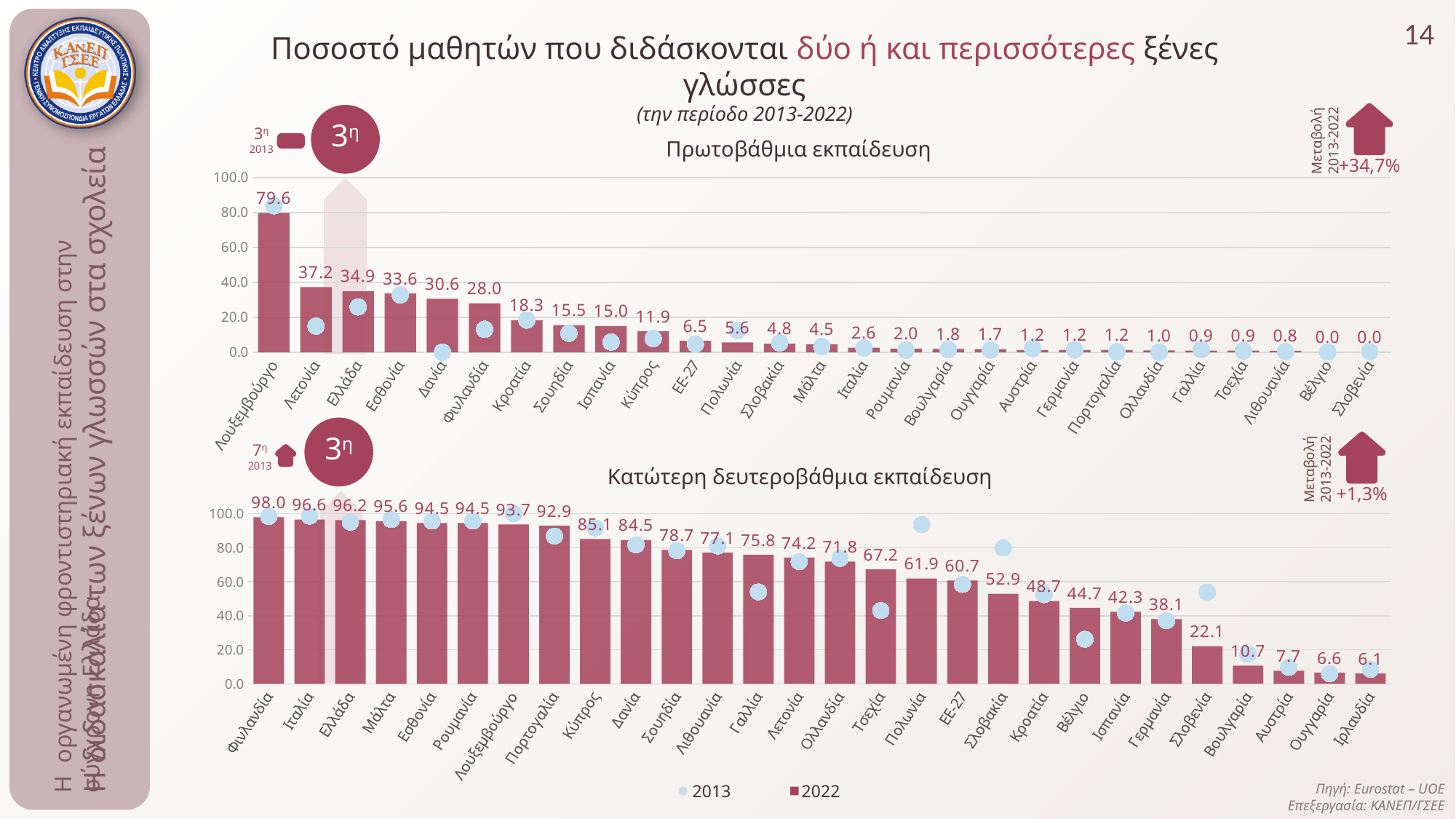
In the top chart (Πρωτοβάθμια εκπαίδευση), which country has the highest 2022 value? Λουξεμβούργο In the top chart (Πρωτοβάθμια εκπαίδευση), what is the 2022 value for ΕΕ-27? 6.5 How many series does the legend at the bottom of the slide list? 2 In the bottom chart (Κατώτερη δευτεροβάθμια εκπαίδευση), which country has the lowest 2022 value? Ιρλανδία In the bottom chart (Κατώτερη δευτεροβάθμια εκπαίδευση), which has a larger 2022 value, Κύπρος or Σλοβακία? Κύπρος In the top chart (Πρωτοβάθμια εκπαίδευση), is the 2013 value for Λουξεμβούργο greater or less than 60.0? greater What type of chart is the top chart (Πρωτοβάθμια εκπαίδευση)? Bar chart In the top chart (Πρωτοβάθμια εκπαίδευση), what is the difference between the 2022 values for Λουξεμβούργο and Λετονία? 42.4 In the top chart (Πρωτοβάθμια εκπαίδευση), what is the 2022 value for Ελλάδα? 34.9 In the bottom chart (Κατώτερη δευτεροβάθμια εκπαίδευση), how many countries/categories are shown on the x axis? 28 In the bottom chart (Κατώτερη δευτεροβάθμια εκπαίδευση), what is the 2022 value for Φινλανδία? 98.0 In the bottom chart (Κατώτερη δευτεροβάθμια εκπαίδευση), is the 2013 value for Γαλλία greater or less than 60.0? less